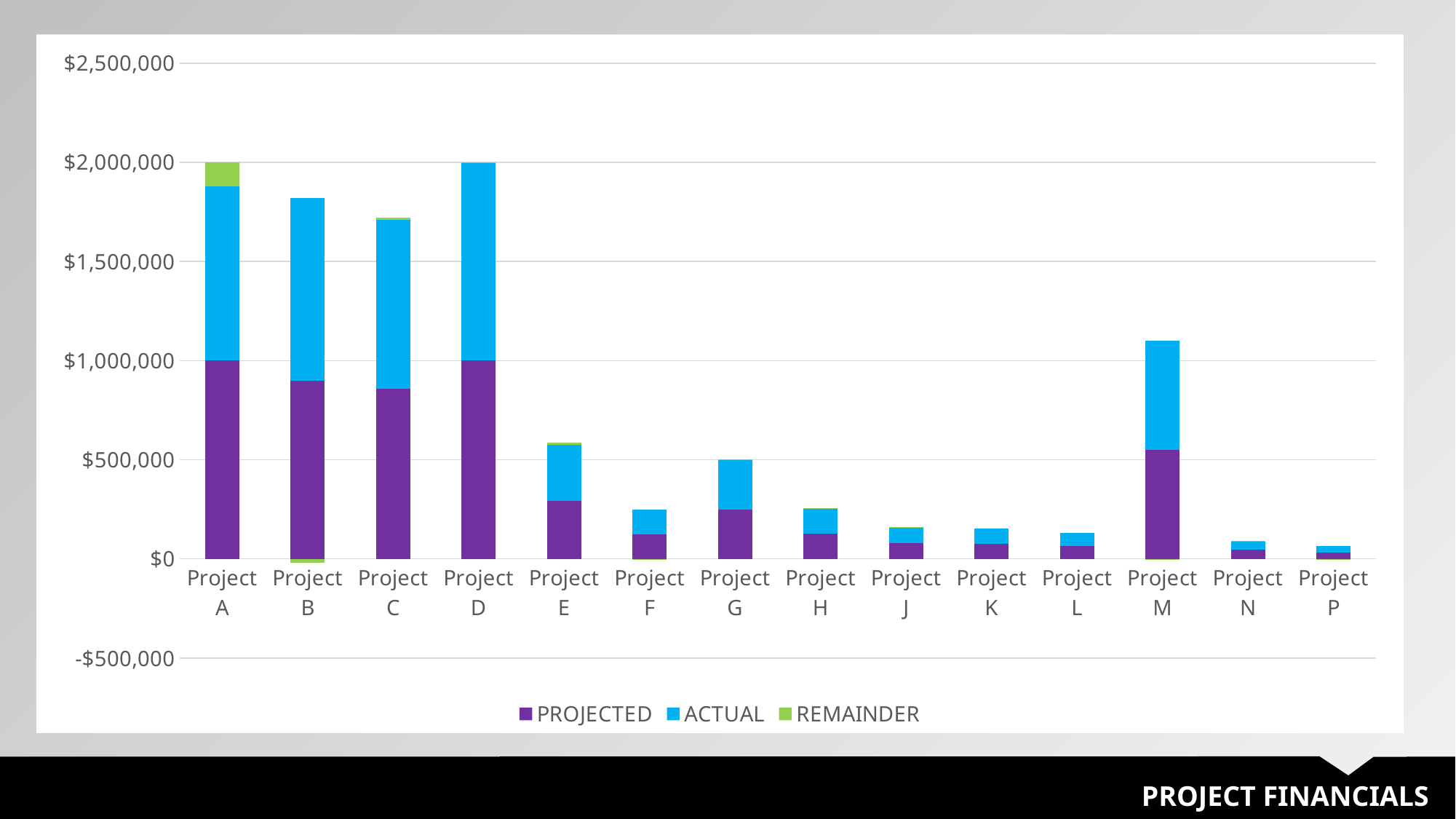
Is the PROJECTED value for Project C greater or less than $1,000,000? less How many projects are shown on the x axis of the chart? 14 How many series does the chart's legend list? 3 Which has the larger total bar, Project G or Project M? Project M Which project has the lowest total bar? Project P Which has the larger total bar, Project B or Project C? Project B Is the total bar for Project M greater or less than $1,000,000? greater Is the total bar for Project B greater or less than $1,500,000? greater What kind of chart is shown on the slide? Stacked bar chart What is the title shown at the bottom of the slide? PROJECT FINANCIALS Which colour represents the ACTUAL series in the chart? Blue